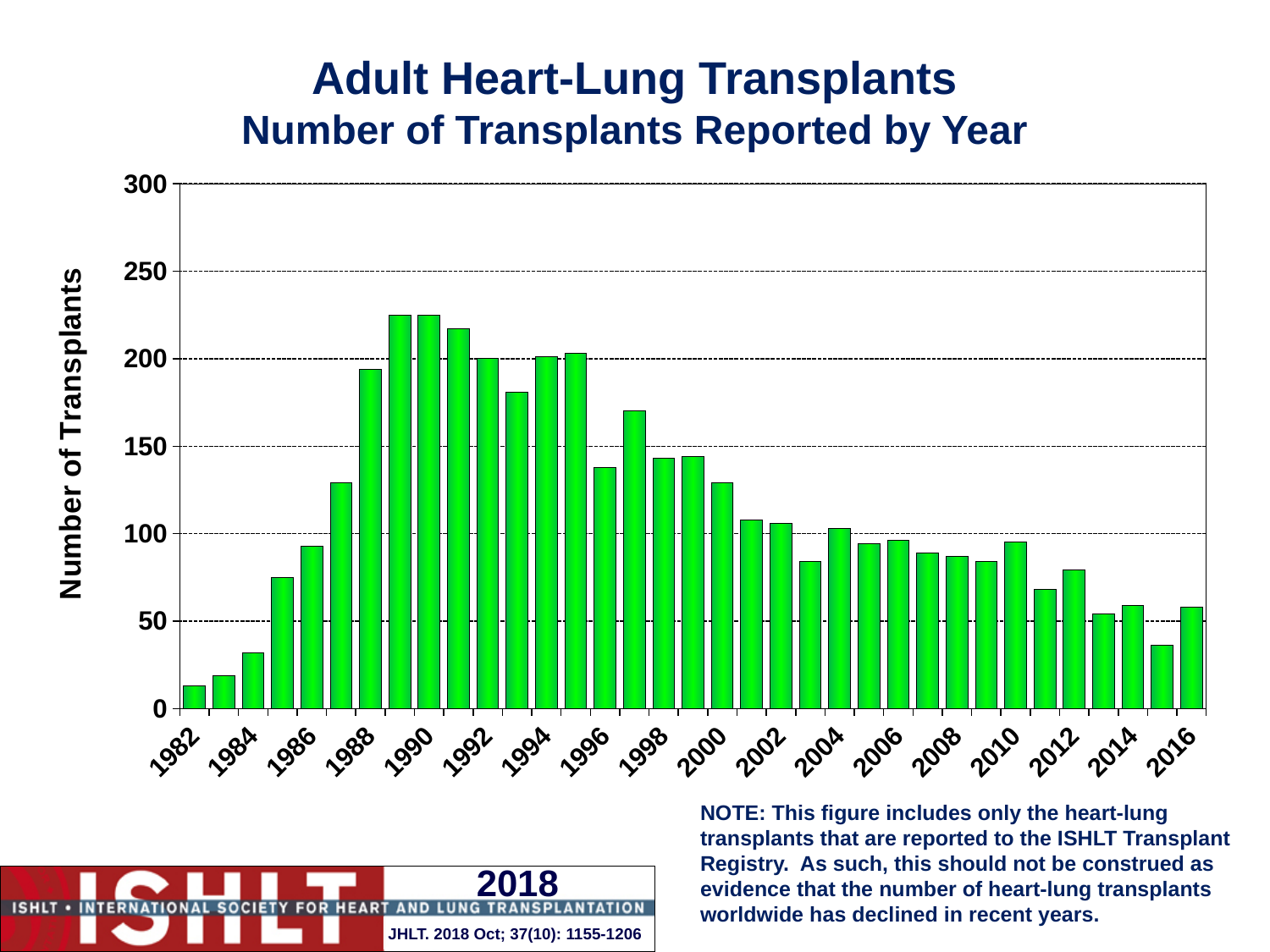
Is the value for 1988 greater or less than 150? greater Which year has the larger number of transplants, 1993 or 1996? 1993 What kind of chart is shown on the slide? Bar chart Is the value for 2011 greater or less than 100? less Is the value for 2001 greater or less than 100? greater Which year has the larger number of transplants, 1996 or 2004? 1996 Do the values rise or fall from 1982 to 1989? Rise Which year has the lowest number of transplants? 1982 How many years (bars) are plotted in the chart? 35 What is the label on the vertical axis? Number of Transplants